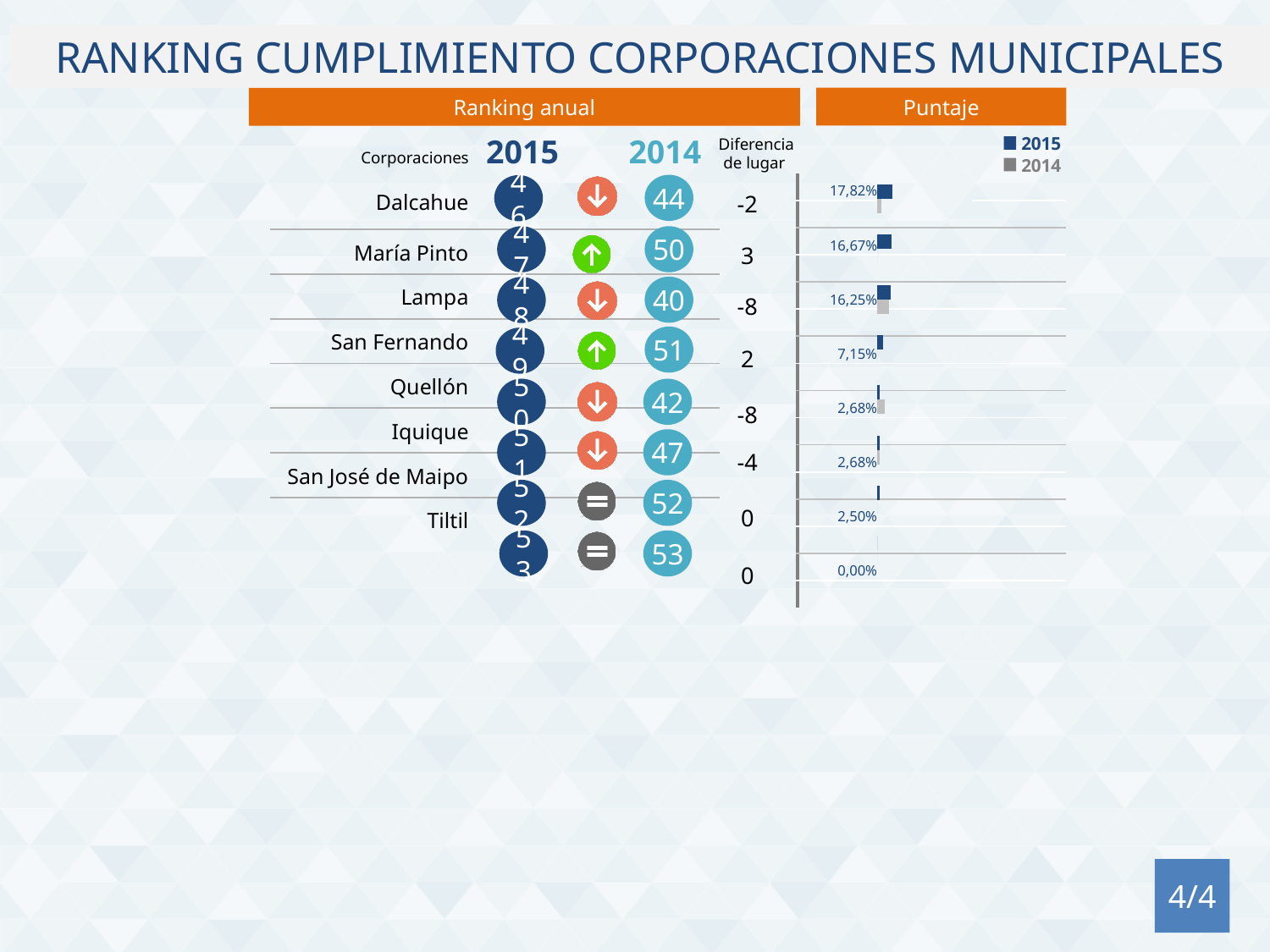
In the Puntaje chart, what is the 2015 value for María Pinto? 16,67% In the Puntaje chart, what is the 2015 value for San Fernando? 7,15% In the Puntaje chart, what is the 2015 value for San José de Maipo? 2,50% What kind of chart is the Puntaje chart? Bar chart In the Puntaje chart, which corporation has the highest 2015 value? Dalcahue In the Puntaje chart, which corporation has the lowest 2015 value? Tiltil In the Puntaje chart, what is the 2015 value for Dalcahue? 17,82% How many series does the legend of the Puntaje chart list? 2 In the Puntaje chart, which has the larger 2015 value, María Pinto or San Fernando? María Pinto In the Puntaje chart, what is the 2015 value for Lampa? 16,25% How many corporations are shown in the Puntaje chart? 8 In the Puntaje chart, what is the difference between the 2015 values for Dalcahue and Lampa? 1,57%